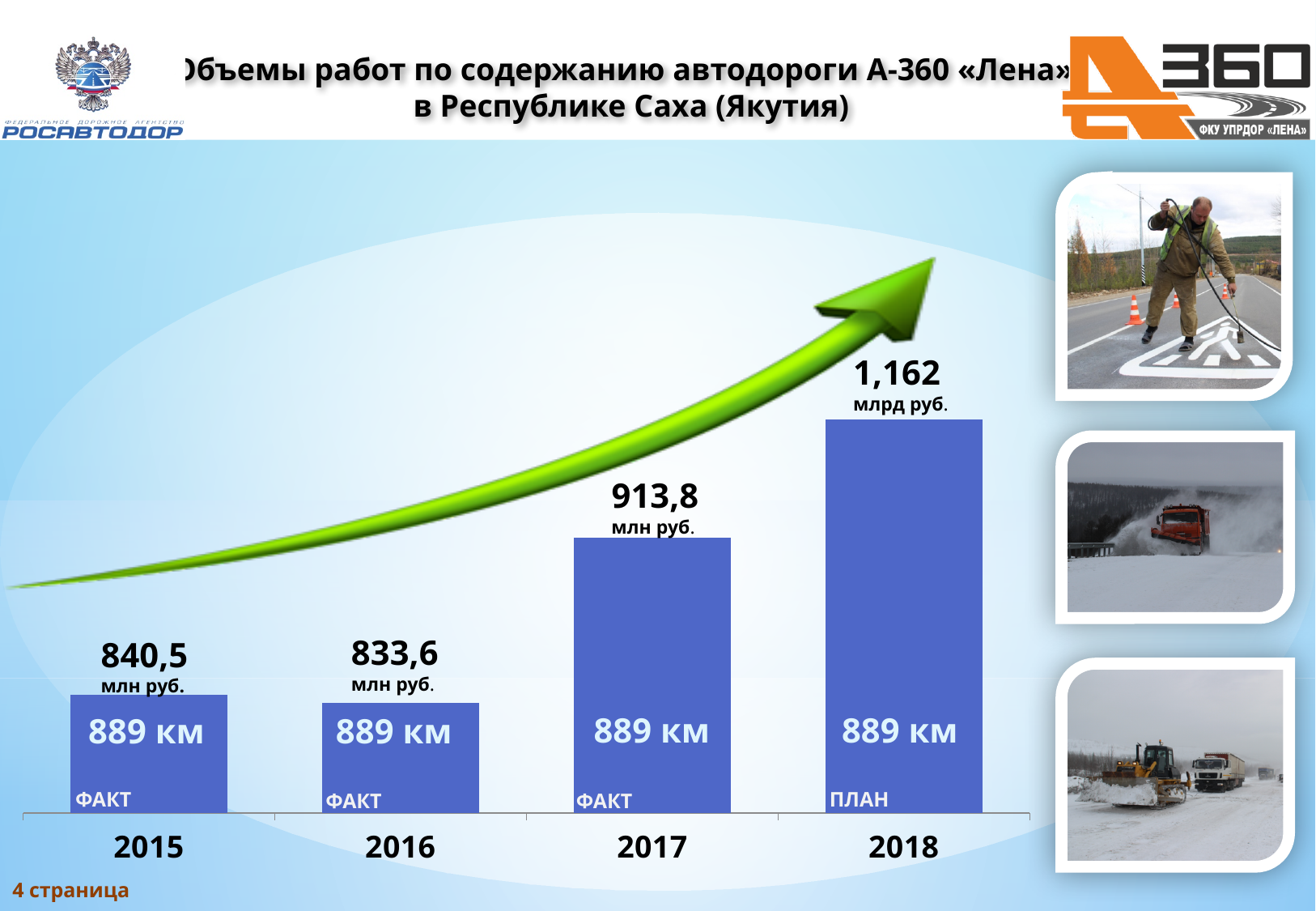
Which year has the highest value? 2018 What value is shown for 2017? 913,8 млн руб. What value is shown for 2016? 833,6 млн руб. How many years are shown on the chart? 4 Which year's bar is labelled ПЛАН rather than ФАКТ? 2018 What kind of chart is this? bar chart Which is larger, the value for 2015 or for 2016? 2015 What is the difference between the 2015 and 2016 values, in млн руб.? 6,9 Which year has the lowest value? 2016 What value is shown for 2018? 1,162 млрд руб. What is the difference between the 2017 and 2015 values, in млн руб.? 73,3 What value is shown for 2015? 840,5 млн руб.